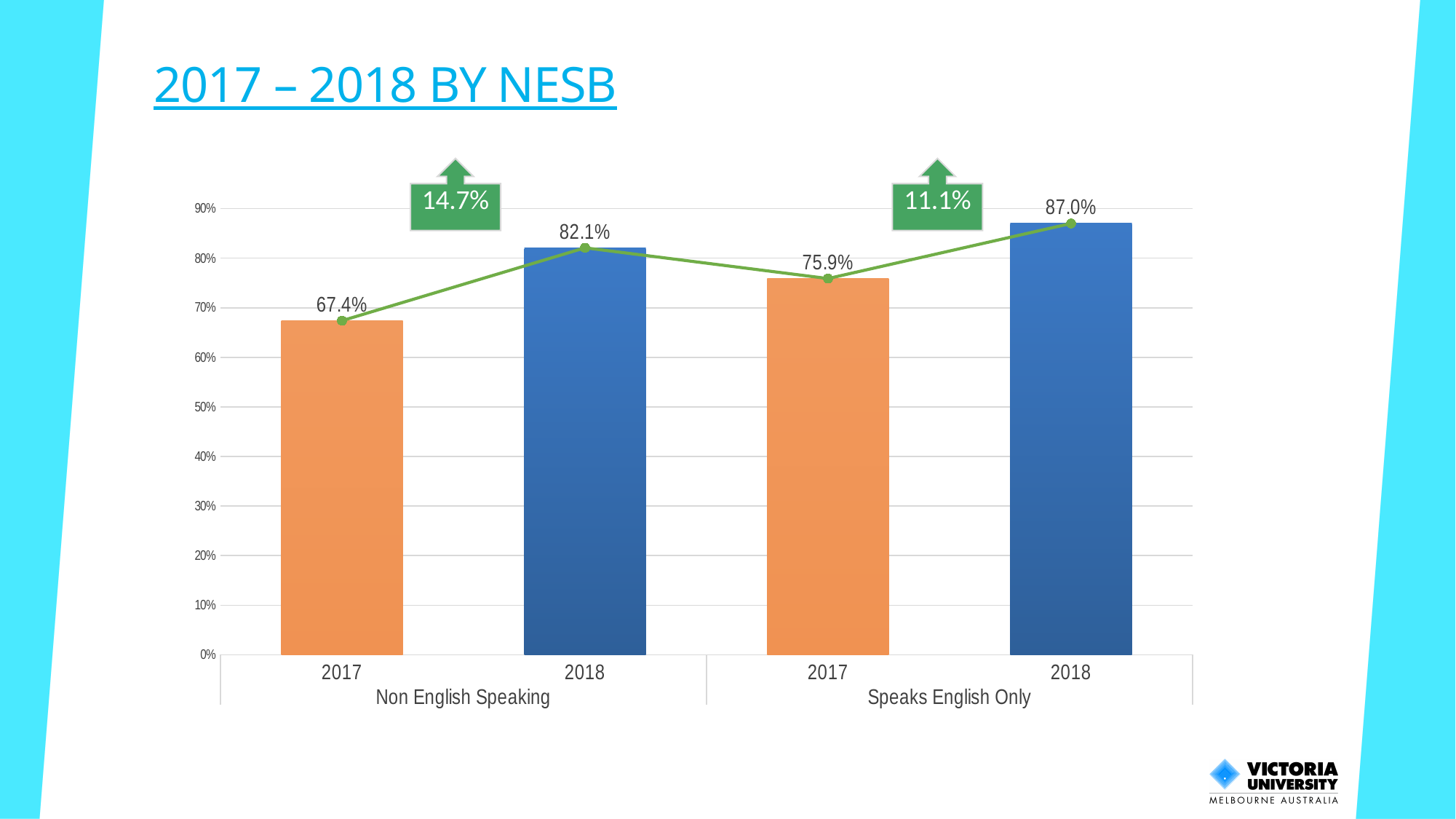
What is the difference between the 2018 and 2017 values for Non English Speaking? 14.7% What kind of chart is shown on the slide? Bar chart with a line overlay How many bars are plotted in the chart? 4 What is the value for Speaks English Only in 2017? 75.9% Which is larger: Non English Speaking 2018 or Speaks English Only 2017? Non English Speaking 2018 What is the value for Non English Speaking in 2018? 82.1% Which bar has the highest value? Speaks English Only 2018 What is the difference between the 2018 and 2017 values for Speaks English Only? 11.1% Which bar has the lowest value? Non English Speaking 2017 What is the value for Speaks English Only in 2018? 87.0% What is the value for Non English Speaking in 2017? 67.4% What is the title of the slide? 2017 – 2018 BY NESB